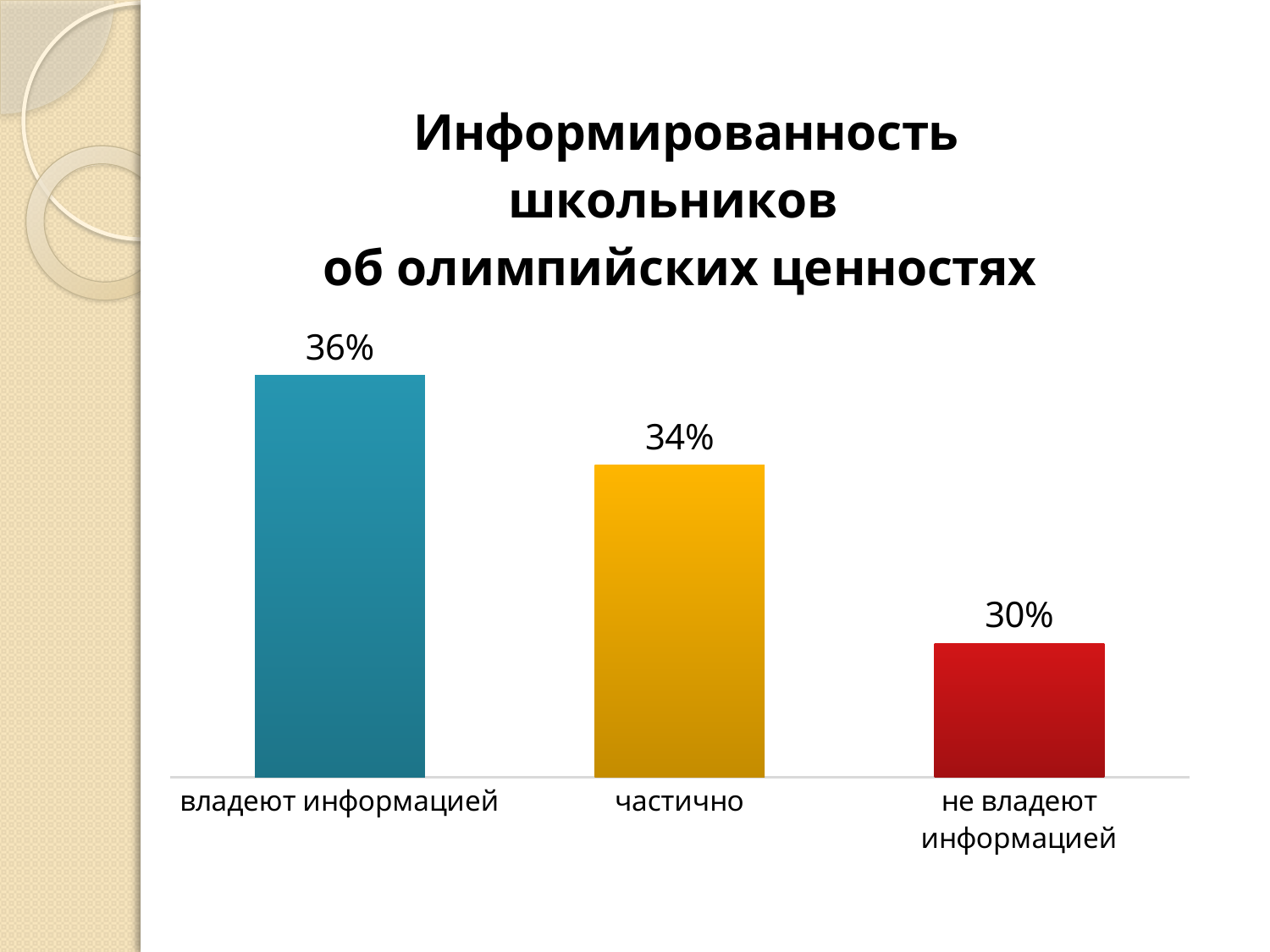
Which category has the highest value? владеют информацией What is the difference between the values for "частично" and "не владеют информацией"? 4% What is the value for "владеют информацией"? 36% How many categories are shown in the chart? 3 Which is larger, the value for "владеют информацией" or the value for "частично"? владеют информацией What kind of chart is shown on the slide? bar chart What is the difference between the values for "владеют информацией" and "не владеют информацией"? 6% Which category has the lowest value? не владеют информацией What is the title of the chart? Информированность школьников об олимпийских ценностях What is the value for "не владеют информацией"? 30% What is the value for "частично"? 34% Do the values rise or fall from left to right across the categories? fall